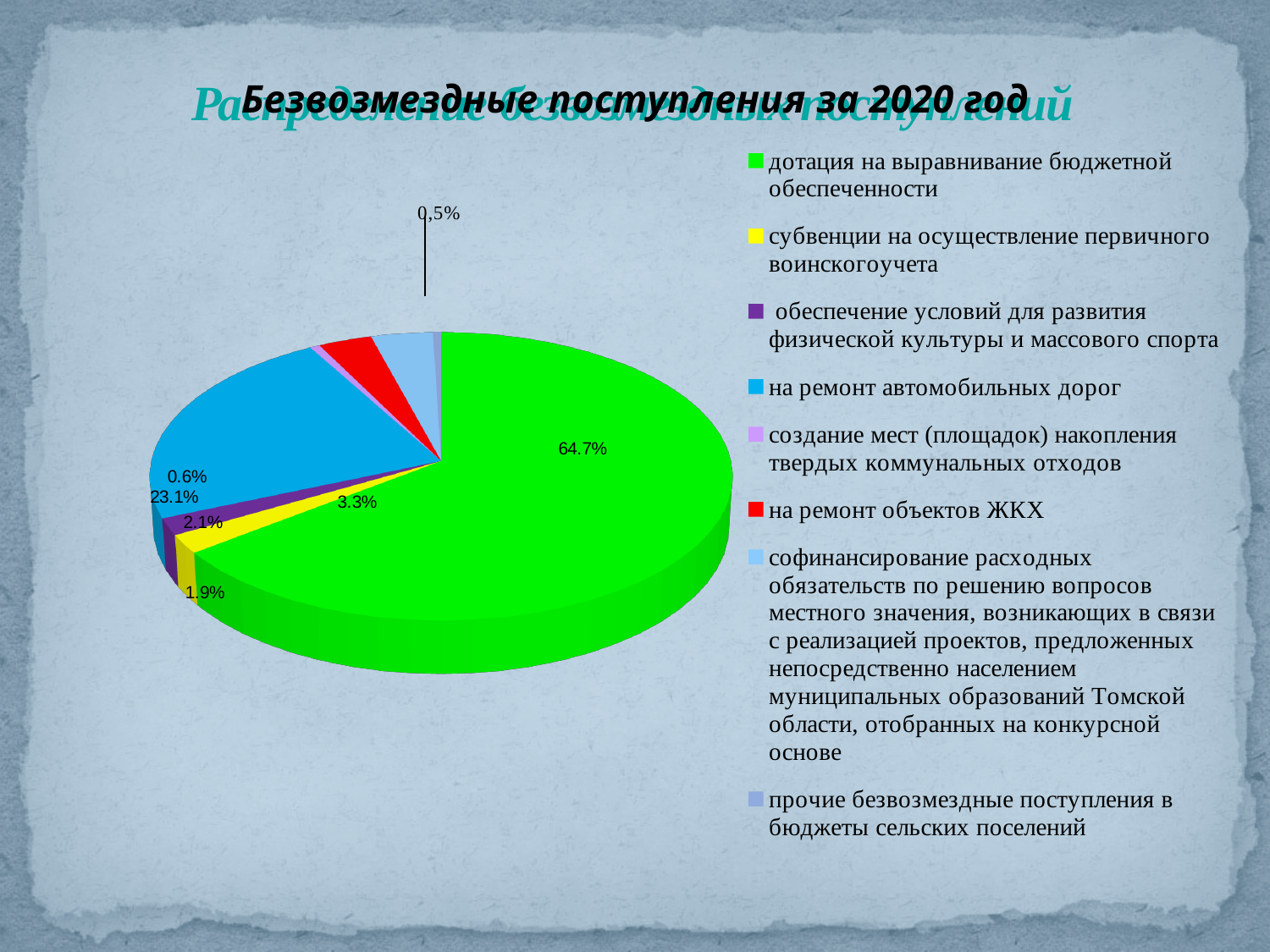
What is the value for субвенции на осуществление первичного воинского учета? 2.1% Which is larger: the share for на ремонт автомобильных дорог or the share for дотация на выравнивание бюджетной обеспеченности? дотация на выравнивание бюджетной обеспеченности What is the difference in percentage points between дотация на выравнивание бюджетной обеспеченности and на ремонт автомобильных дорог? 41.6 What kind of chart is shown on the slide? pie chart What colour is the slice for дотация на выравнивание бюджетной обеспеченности? green What is the value for создание мест (площадок) накопления твердых коммунальных отходов? 0.6% What is the title of the chart? Безвозмездные поступления за 2020 год What share of the pie is дотация на выравнивание бюджетной обеспеченности? 64.7% How many categories does the legend list? 8 What is the value for обеспечение условий для развития физической культуры и массового спорта? 1.9% Which category has the largest share of the pie? дотация на выравнивание бюджетной обеспеченности What is the value for на ремонт автомобильных дорог? 23.1%